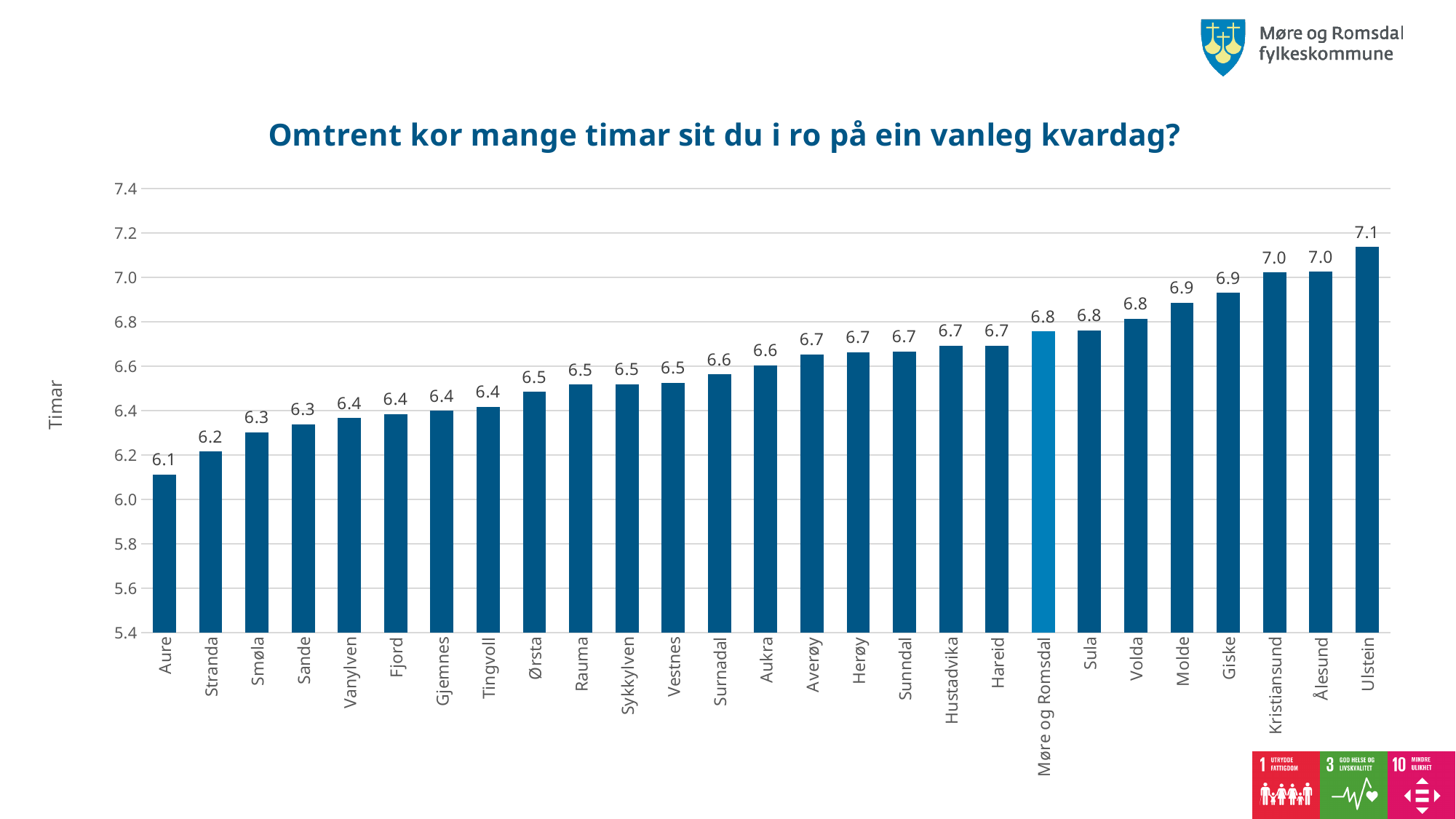
What kind of chart is shown? Bar chart Which municipality has the lowest value? Aure Which municipality has the highest value? Ulstein Do the values rise or fall from left to right along the x axis? Rise What is the value for Kristiansund? 7.0 What is the value for Møre og Romsdal? 6.8 Which has a larger value, Molde or Smøla? Molde What is the title of the chart? Omtrent kor mange timar sit du i ro på ein vanleg kvardag? What is the difference between the values for Ulstein and Aure? 1.0 What is the value for Aure? 6.1 How many municipalities/categories are shown on the x axis? 27 Is the value for Ulstein greater or less than 7.0? greater